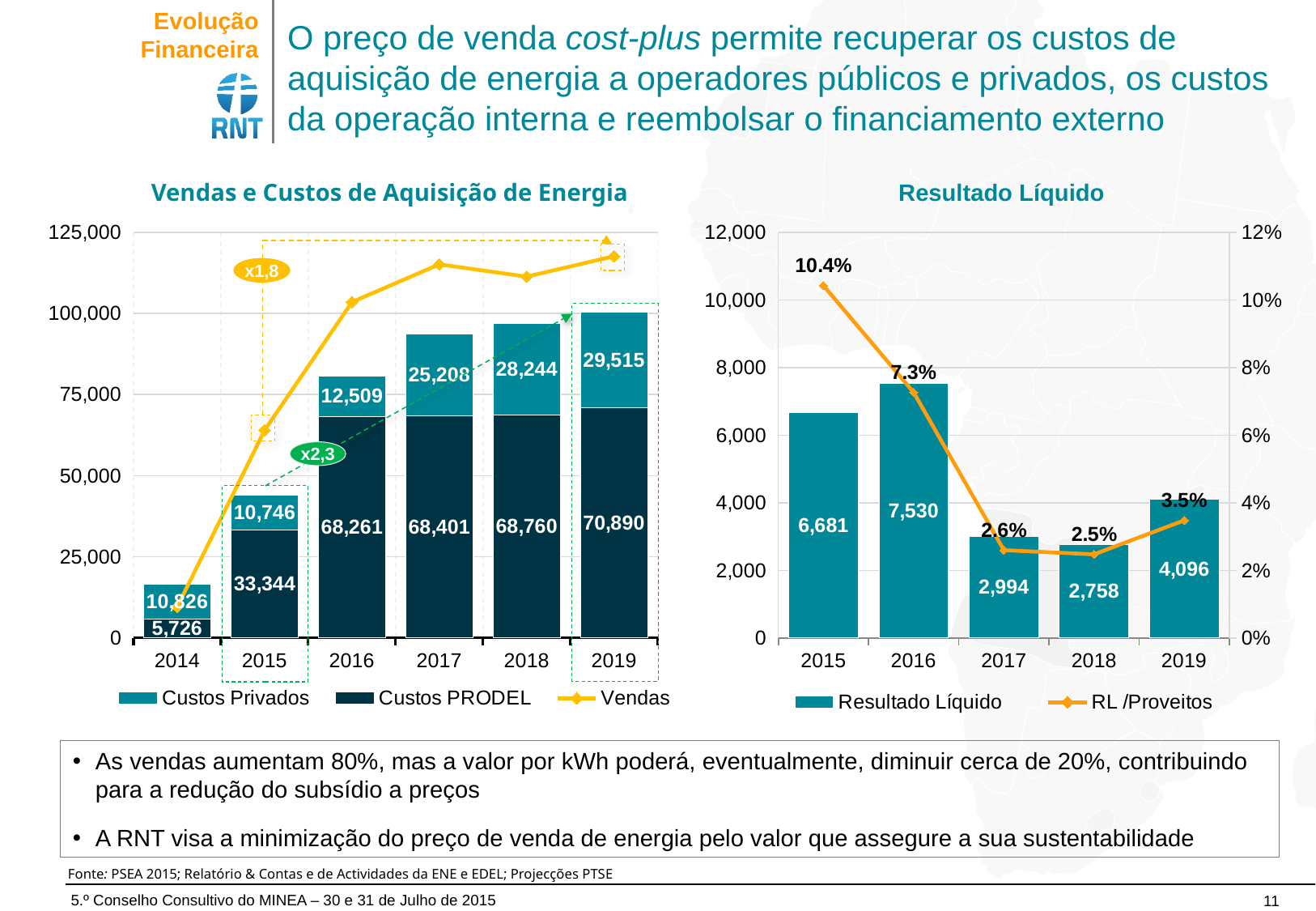
In the 'Vendas e Custos de Aquisição de Energia' chart, how many years are shown on the x axis? 6 In the 'Vendas e Custos de Aquisição de Energia' chart, by how much did Custos Privados increase from 2017 to 2018? 3,036 In the 'Resultado Líquido' chart, which year has the highest Resultado Líquido? 2016 In the 'Vendas e Custos de Aquisição de Energia' chart, what is the value of Custos Privados in 2019? 29,515 In the 'Vendas e Custos de Aquisição de Energia' chart, is the Vendas value for 2014 greater or less than 25,000? less In the 'Vendas e Custos de Aquisição de Energia' chart, what is the total of the stacked bar for 2015 (Custos Privados plus Custos PRODEL)? 44,090 In the 'Vendas e Custos de Aquisição de Energia' chart, what is the value of Custos PRODEL in 2016? 68,261 In the 'Resultado Líquido' chart, what is the RL /Proveitos value for 2017? 2.6% In the 'Resultado Líquido' chart, how many series does the legend list? 2 In the 'Vendas e Custos de Aquisição de Energia' chart, which year has the higher Custos PRODEL value, 2018 or 2019? 2019 In the 'Resultado Líquido' chart, what is the difference between the Resultado Líquido in 2016 and in 2015? 849 In the 'Resultado Líquido' chart, which year has the lowest Resultado Líquido? 2018